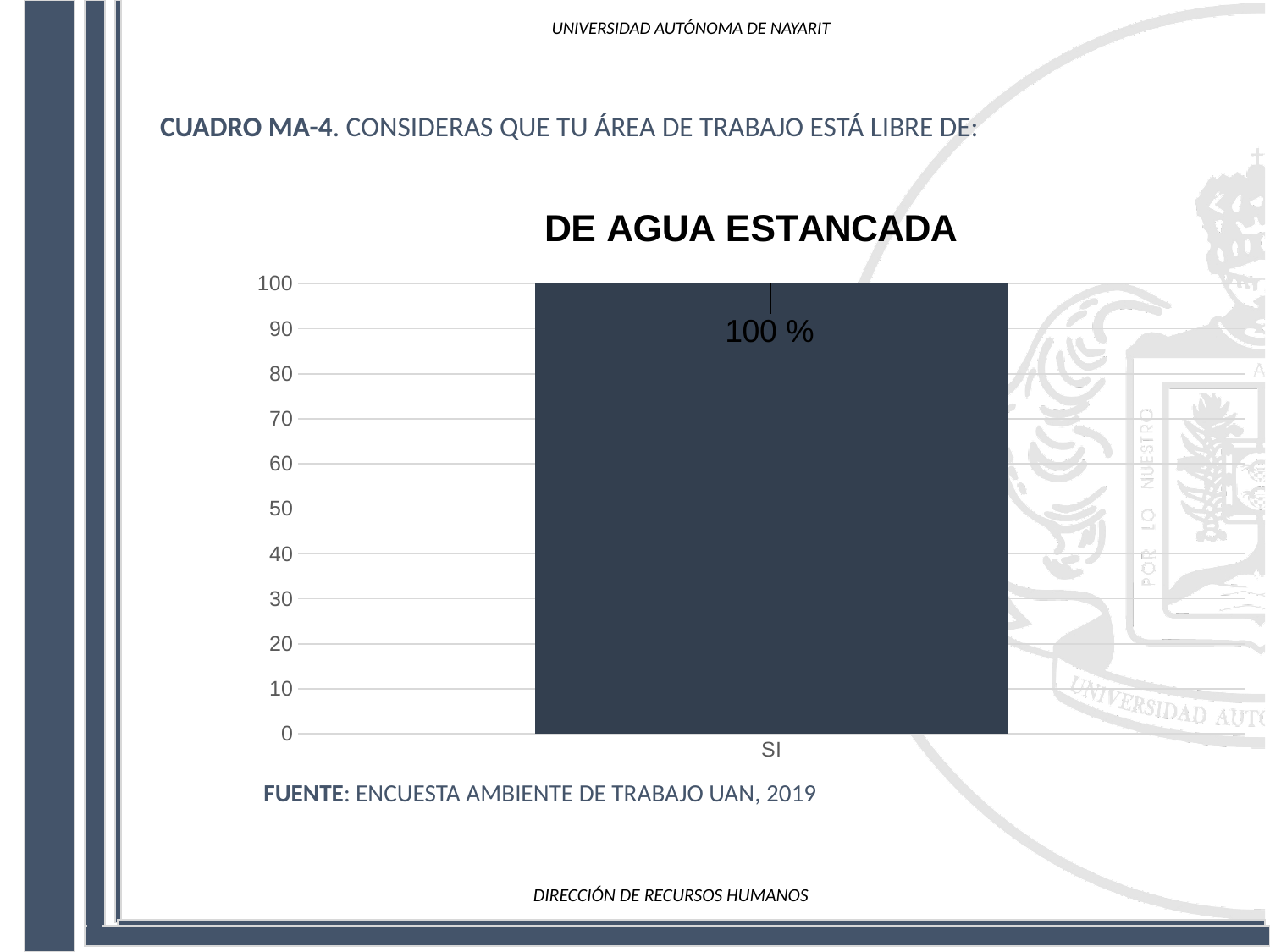
What is the value shown for the SI category? 100 % What type of chart is shown on the slide? bar chart What is the label of the only category on the x axis? SI What is the title of the chart? DE AGUA ESTANCADA How many categories are plotted on the x axis? 1 What is the highest value shown on the vertical axis? 100 Is the value for SI greater or less than 50? greater